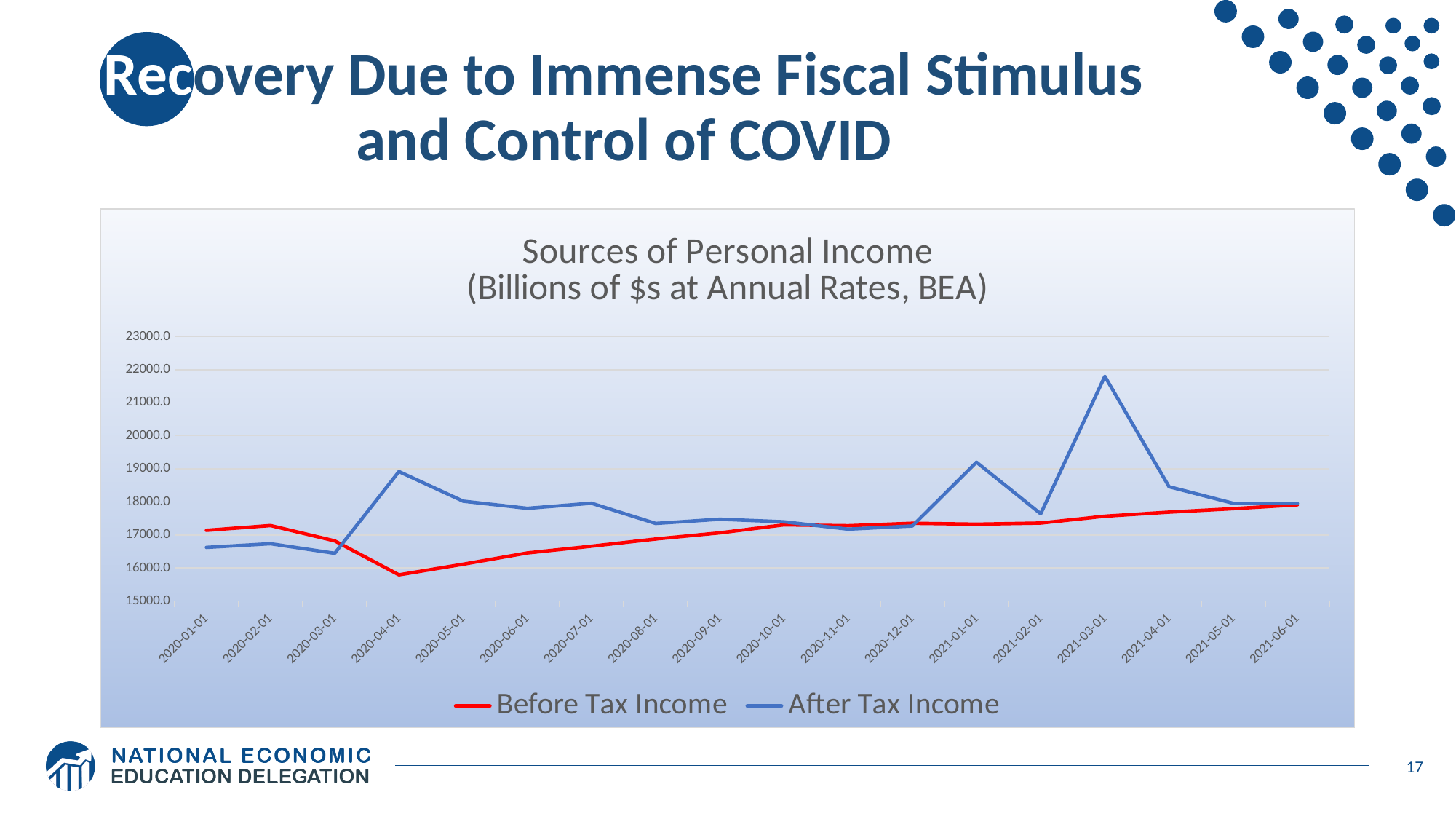
At which date does After Tax Income reach its highest value? 2021-03-01 At which date does Before Tax Income reach its lowest value? 2020-04-01 Is the value for After Tax Income at 2020-04-01 greater or less than 18000.0? greater How many series does the legend list? 2 What is the title of the chart? Sources of Personal Income (Billions of $s at Annual Rates, BEA) What kind of chart is shown on the slide? Line chart At 2020-01-01, which series has the larger value, Before Tax Income or After Tax Income? Before Tax Income Is the value for Before Tax Income at 2020-04-01 greater or less than 16000.0? less At 2020-04-01, which series has the larger value, Before Tax Income or After Tax Income? After Tax Income How many dates are plotted along the x axis? 18 Is the value for After Tax Income at 2021-03-01 greater or less than 21000.0? greater Does Before Tax Income rise or fall from 2020-04-01 to 2021-06-01? Rise